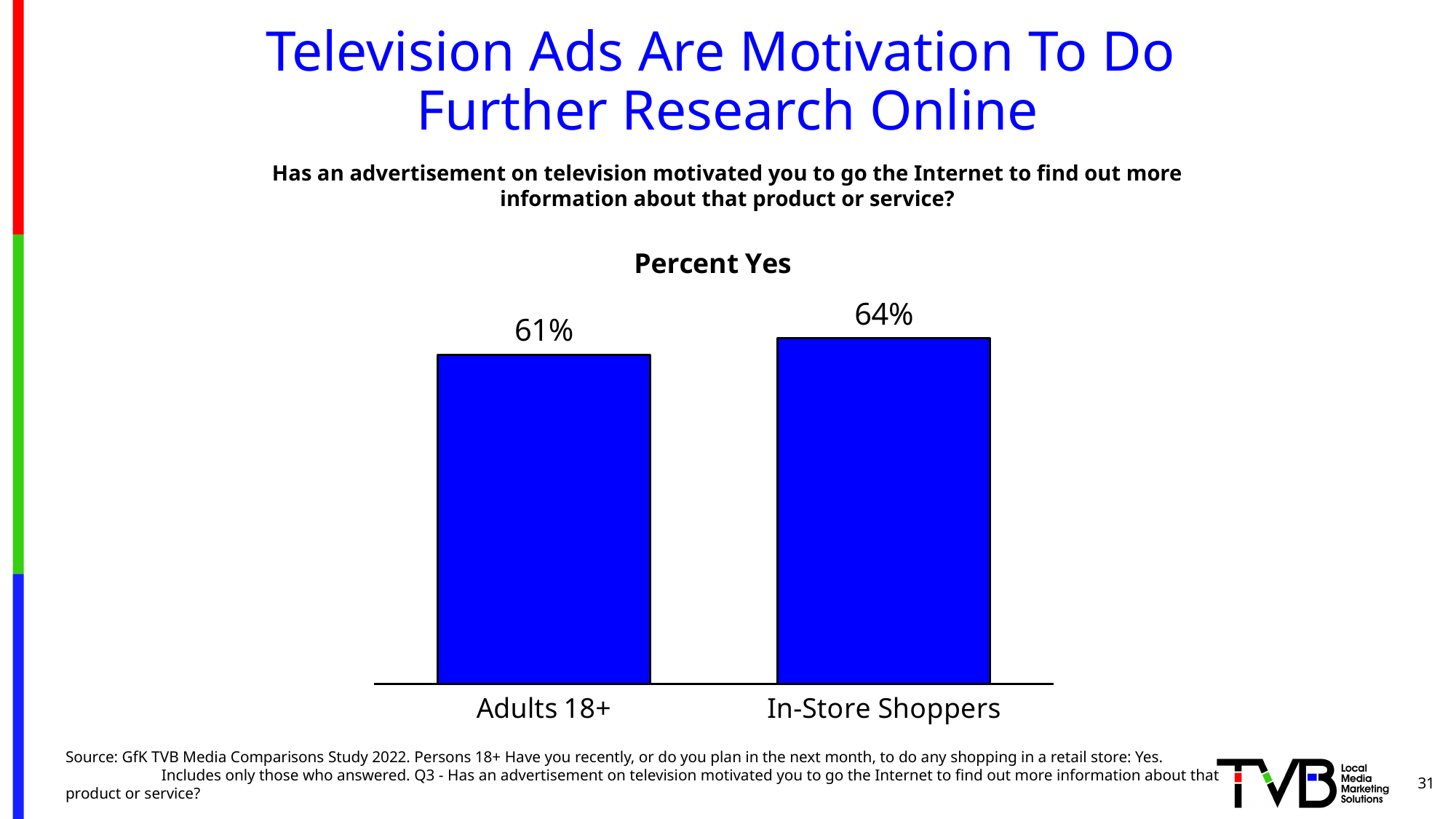
What is the Percent Yes value for In-Store Shoppers? 64% Which category has the higher Percent Yes value? In-Store Shoppers What colour are the bars in the chart? blue Which category has the lower Percent Yes value? Adults 18+ What kind of chart is shown on the slide? bar chart What is the Percent Yes value for Adults 18+? 61% What is the difference in percentage points between In-Store Shoppers and Adults 18+? 3 How many categories are shown in the chart? 2 What is the title of the chart? Percent Yes Is the value for In-Store Shoppers larger or smaller than the value for Adults 18+? larger